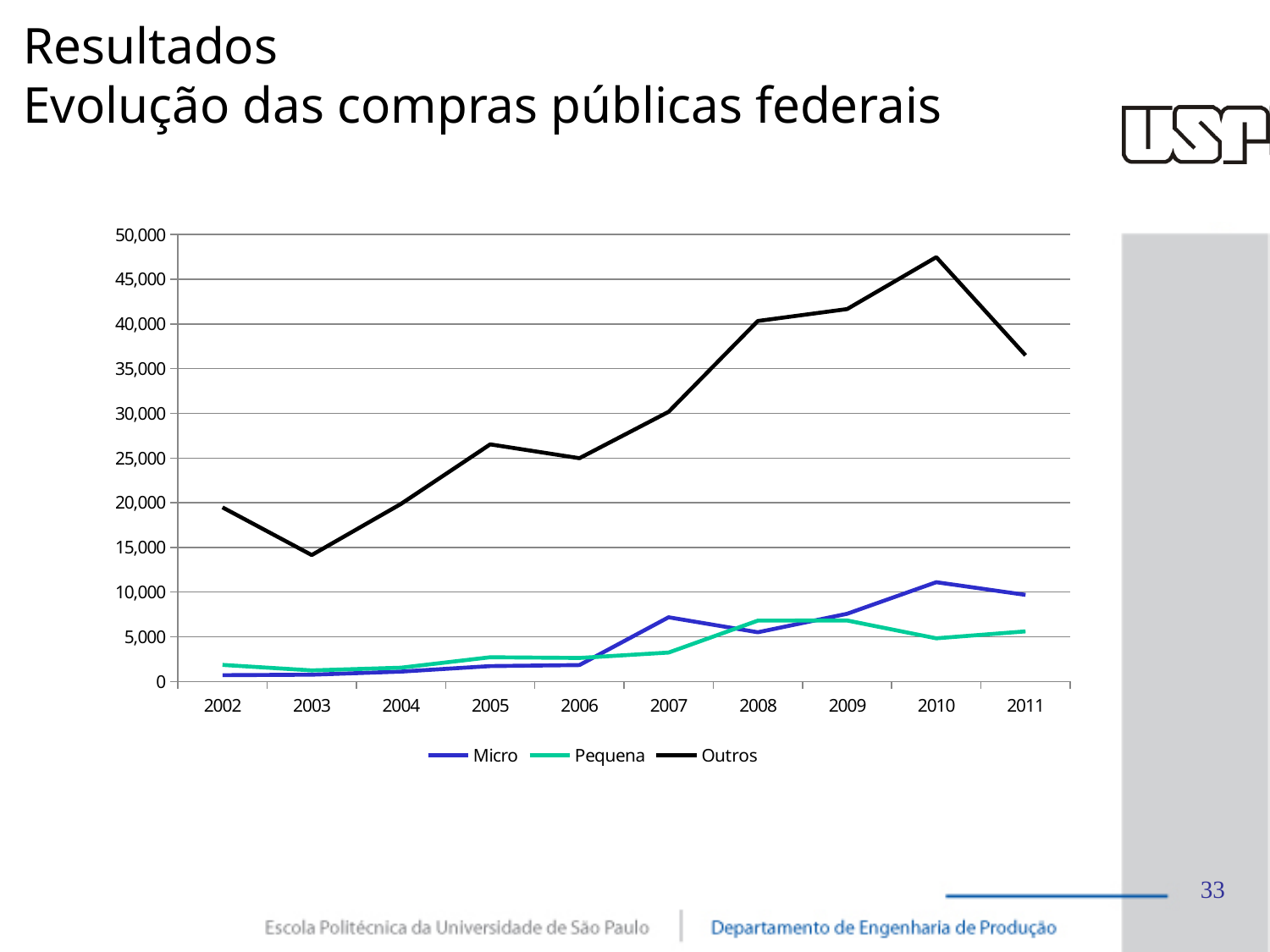
Is the value for Micro in 2010 greater or less than 10,000? greater How many series does the legend list? 3 Which series has the larger value in 2008, Micro or Pequena? Pequena Is the value for Outros in 2011 greater or less than 35,000? greater Is the value for Outros in 2010 greater or less than 45,000? greater In which year does the Outros series reach its lowest value? 2003 Does the Outros series rise or fall from 2003 to 2010? rise How many years are plotted along the x axis? 10 Which series is listed last in the legend? Outros What kind of chart is shown on the slide? line chart In which year does the Outros series reach its highest value? 2010 In which year does the Micro series reach its highest value? 2010